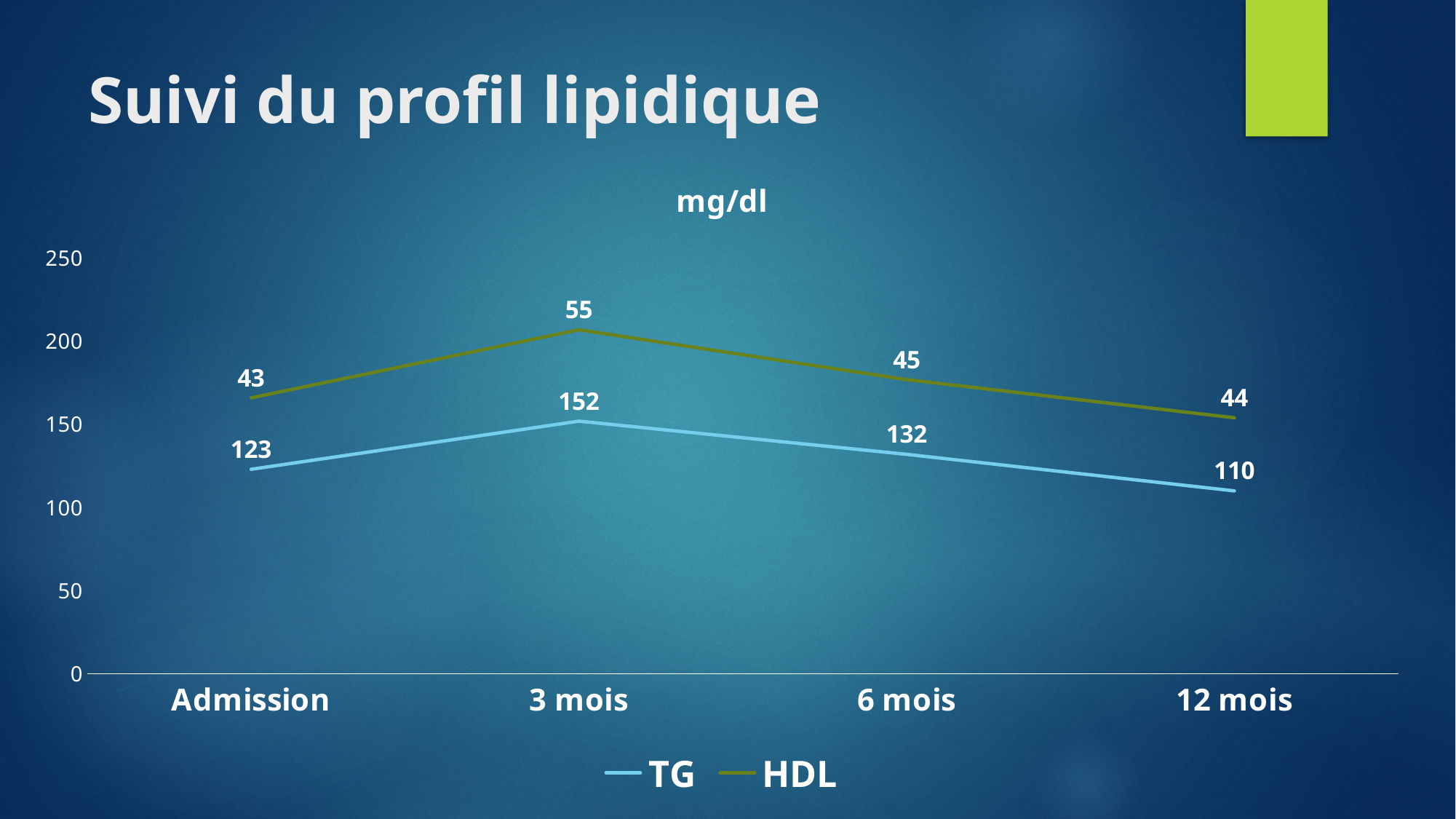
What kind of chart is shown on the slide? Line chart At which time point is the TG value lowest? 12 mois What is the difference between the TG value at 3 mois and the TG value at 12 mois? 42 How many series does the legend list? 2 What is the HDL value at Admission? 43 What is the TG value at 3 mois? 152 How many time points are shown on the x axis? 4 At which time point is the HDL value highest? 3 mois At which time point is the TG value highest? 3 mois What is the TG value at 12 mois? 110 What is the HDL value at 6 mois? 45 Which is larger, the HDL value at Admission or the HDL value at 12 mois? 12 mois